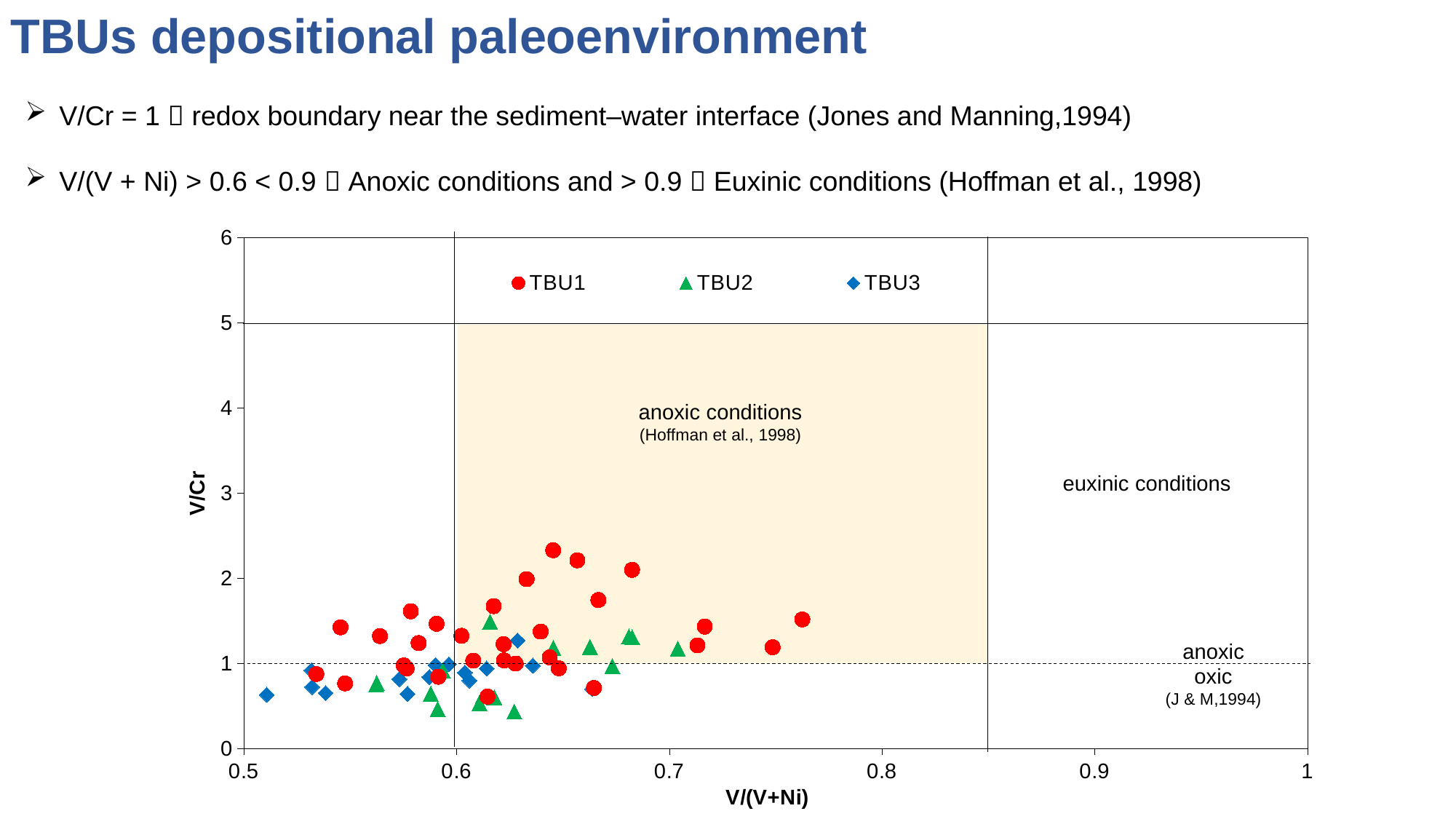
What is the label of the y axis? V/Cr What kind of chart is shown on the slide? scatter chart What is the maximum value shown on the y axis? 6 What are the names of the series in the legend? TBU1, TBU2, TBU3 How many series does the legend list? 3 Which series has the point with the largest V/(V+Ni) value? TBU1 Which series contains the point with the lowest V/(V+Ni) value? TBU3 Is the largest V/(V+Ni) value plotted greater or less than 0.8? less Is the highest V/Cr value plotted greater or less than 2? greater Which series contains the point with the highest V/Cr value? TBU1 Is the highest V/Cr value plotted greater or less than 3? less What is the label of the x axis? V/(V+Ni)